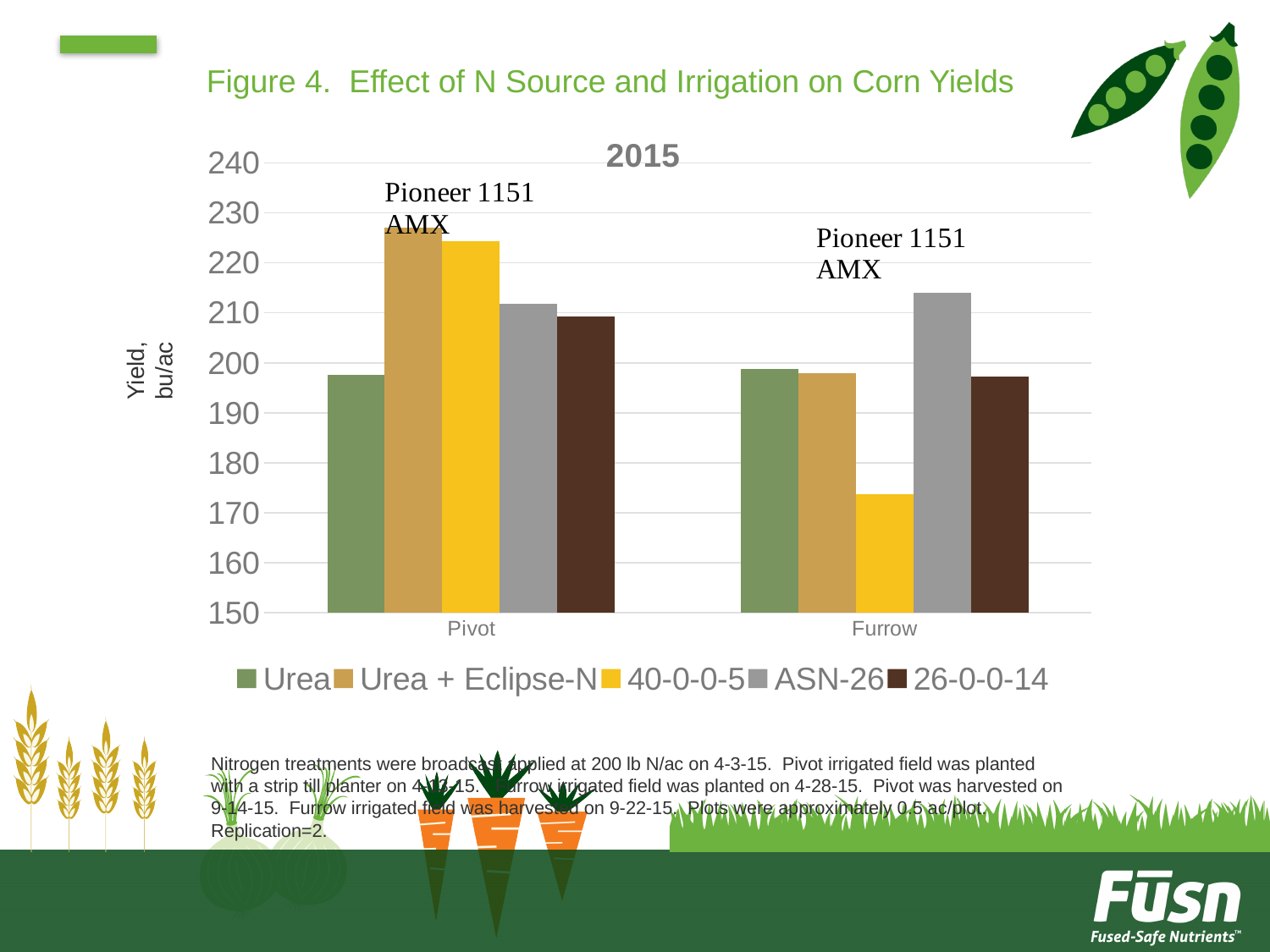
Is the yield for Urea + Eclipse-N under Pivot greater or less than 220? greater Is the yield for 40-0-0-5 higher under Pivot or under Furrow? Pivot Which series has the lowest yield in the Furrow category? 40-0-0-5 Which series has the highest yield in the Furrow category? ASN-26 Which series has the highest yield in the Pivot category? Urea + Eclipse-N Is the yield for 40-0-0-5 under Furrow greater or less than 180? less What is the label on the y axis of the chart? Yield, bu/ac What kind of chart is shown on the slide? Bar chart Which series has the lowest yield in the Pivot category? Urea How many series does the chart legend list? 5 What is the title shown above the chart's plot area? 2015 How many categories are shown on the x axis of the chart? 2